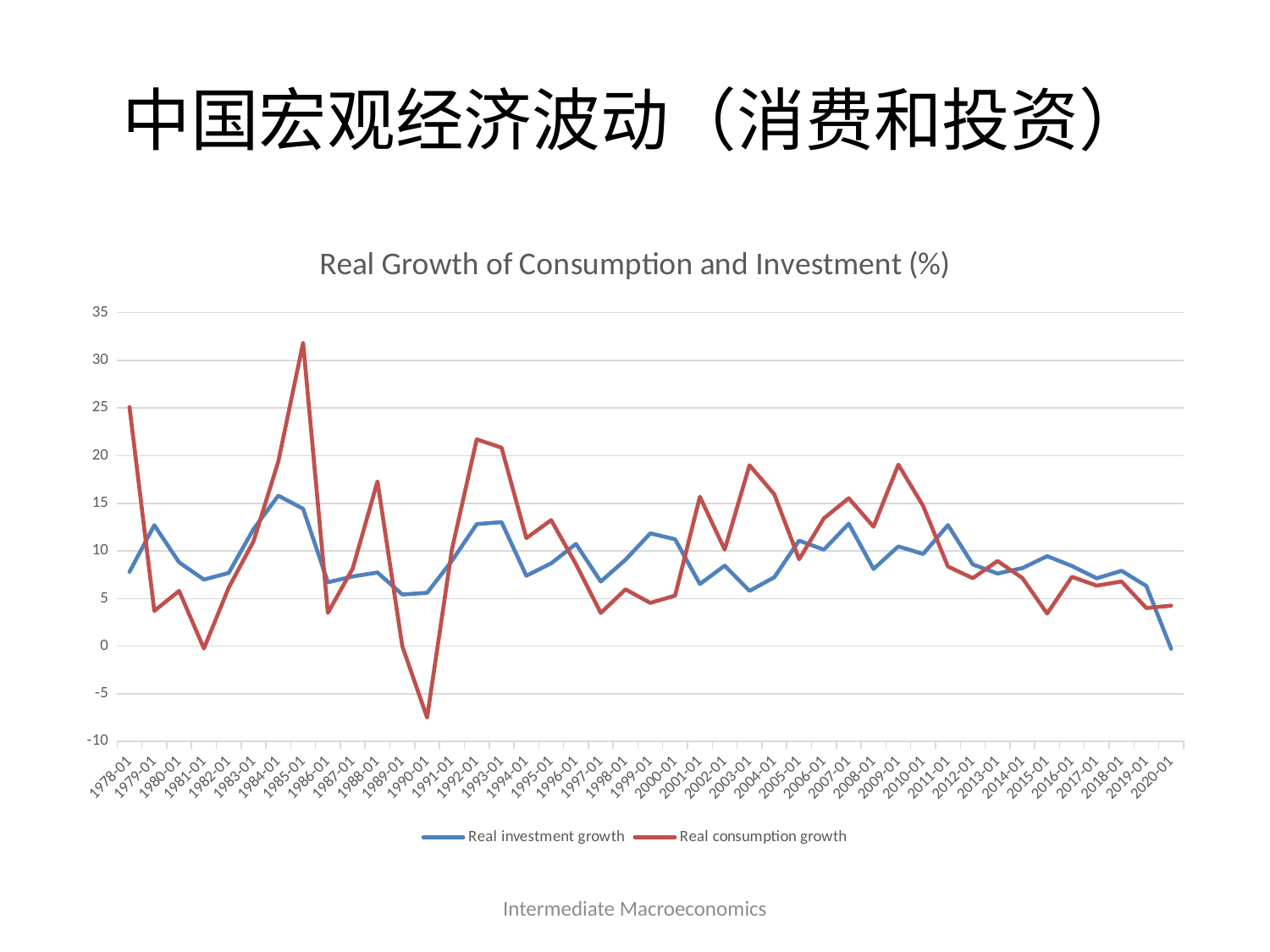
Is the value of Real consumption growth at 1990-01 greater or less than -5? less What kind of chart is shown on the slide? Line chart What is the title of the chart? Real Growth of Consumption and Investment (%) How many yearly points are plotted along the x axis, from 1978-01 to 2020-01? 43 Does Real consumption growth rise or fall from 2009-01 to 2012-01? Fall At 1990-01, which series has the larger value, Real investment growth or Real consumption growth? Real investment growth How many series does the legend list? 2 In which year does Real consumption growth reach its highest value? 1985-01 In which year does Real investment growth reach its lowest value? 2020-01 Which series is drawn in red? Real consumption growth Is the value of Real consumption growth at 1985-01 greater or less than 30? greater In which year does Real consumption growth reach its lowest value? 1990-01